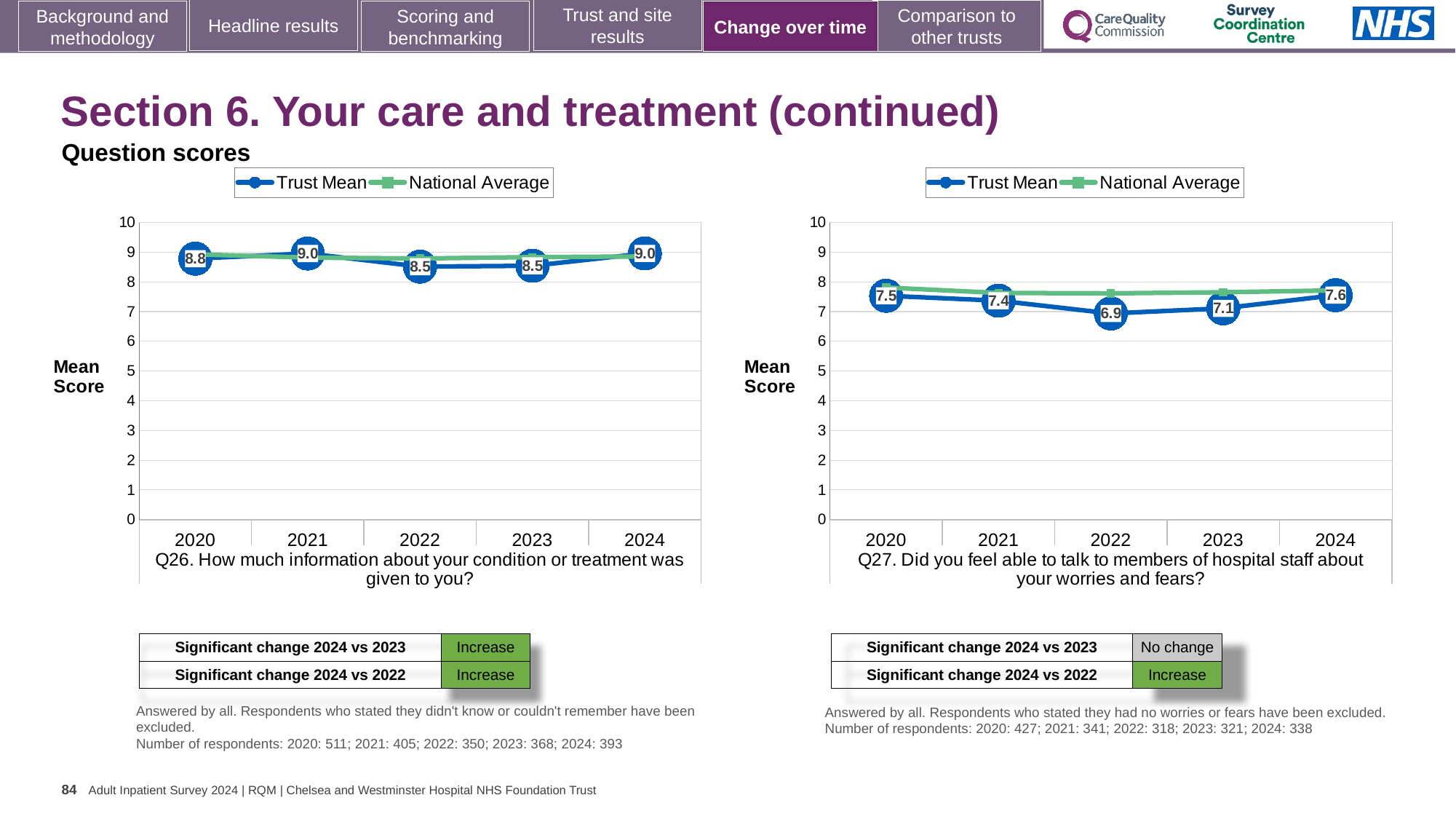
How many years are plotted on the x axis of the Q26 chart? 5 How many series does the legend of the Q27 chart list? 2 In the Q26 chart, what is the Trust Mean score for 2022? 8.5 In the Q27 chart, which year has the lowest Trust Mean score? 2022 In the Q27 chart, is the Trust Mean value for 2022 greater or less than 7? less In the Q27 chart, which year has the highest Trust Mean score? 2024 In the Q27 chart, what is the Trust Mean score for 2024? 7.6 In the Q26 chart, what is the Trust Mean score for 2021? 9.0 In the Q27 chart, what is the Trust Mean score for 2022? 6.9 In the Q26 chart, is the Trust Mean score for 2020 larger or smaller than the Trust Mean score for 2021? smaller In the Q26 chart, what is the difference between the Trust Mean scores for 2024 and 2023? 0.5 In the Q27 chart, what is the difference between the Trust Mean scores for 2020 and 2022? 0.6